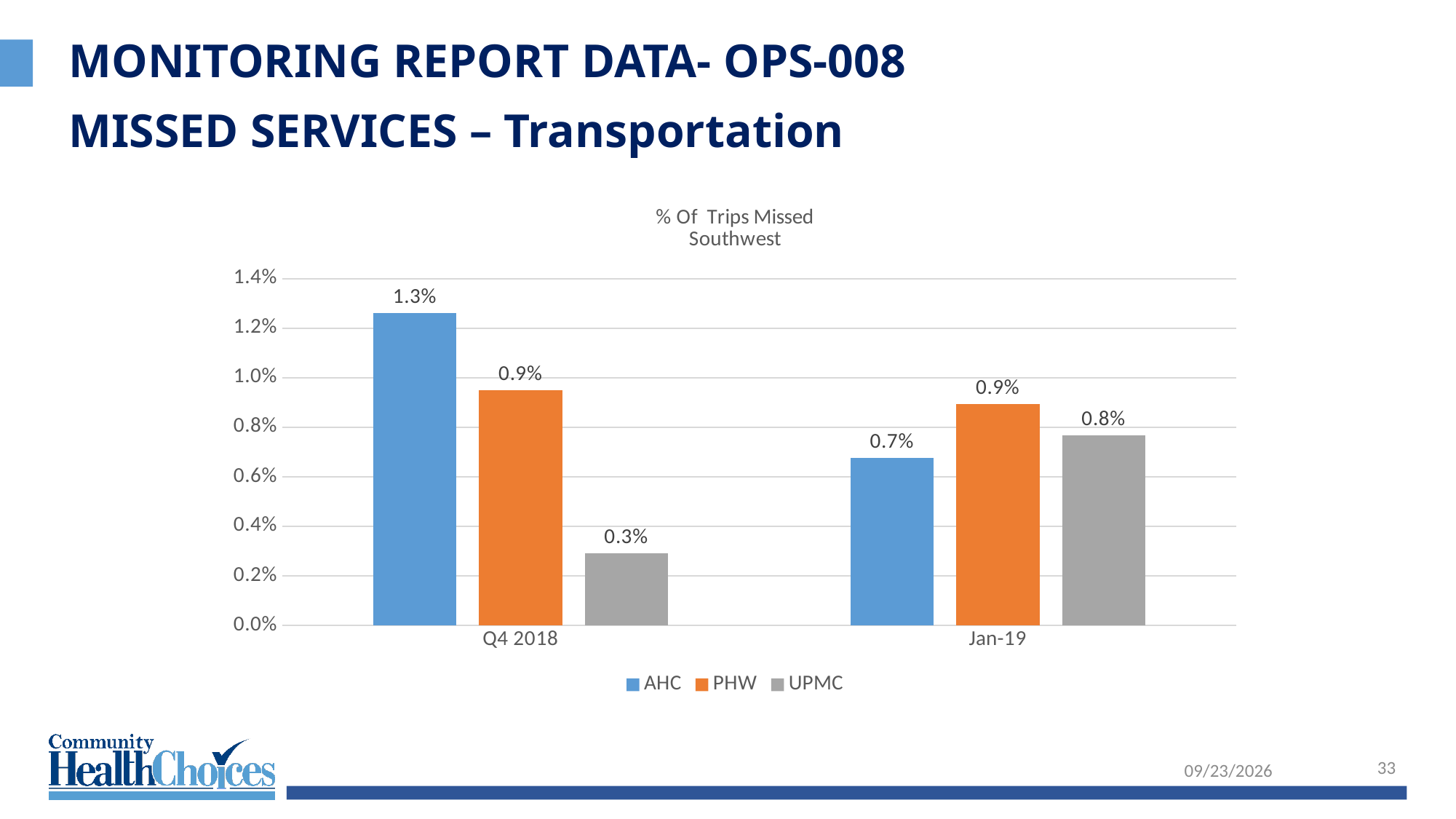
What is the value for AHC in Q4 2018? 1.3% Which series has the highest value in Q4 2018? AHC How many series does the legend list? 3 What is the difference between the AHC and UPMC values in Q4 2018? 1.0% Does the value for AHC rise or fall from Q4 2018 to Jan-19? Fall Which is larger in Jan-19, the value for AHC or the value for UPMC? UPMC What is the value for PHW in Q4 2018? 0.9% Is the value for AHC in Q4 2018 greater or less than 1.0%? greater How many time periods are shown on the x axis? 2 Which series has the lowest value in Q4 2018? UPMC What is the value for UPMC in Jan-19? 0.8% What kind of chart is shown on the slide? Bar chart